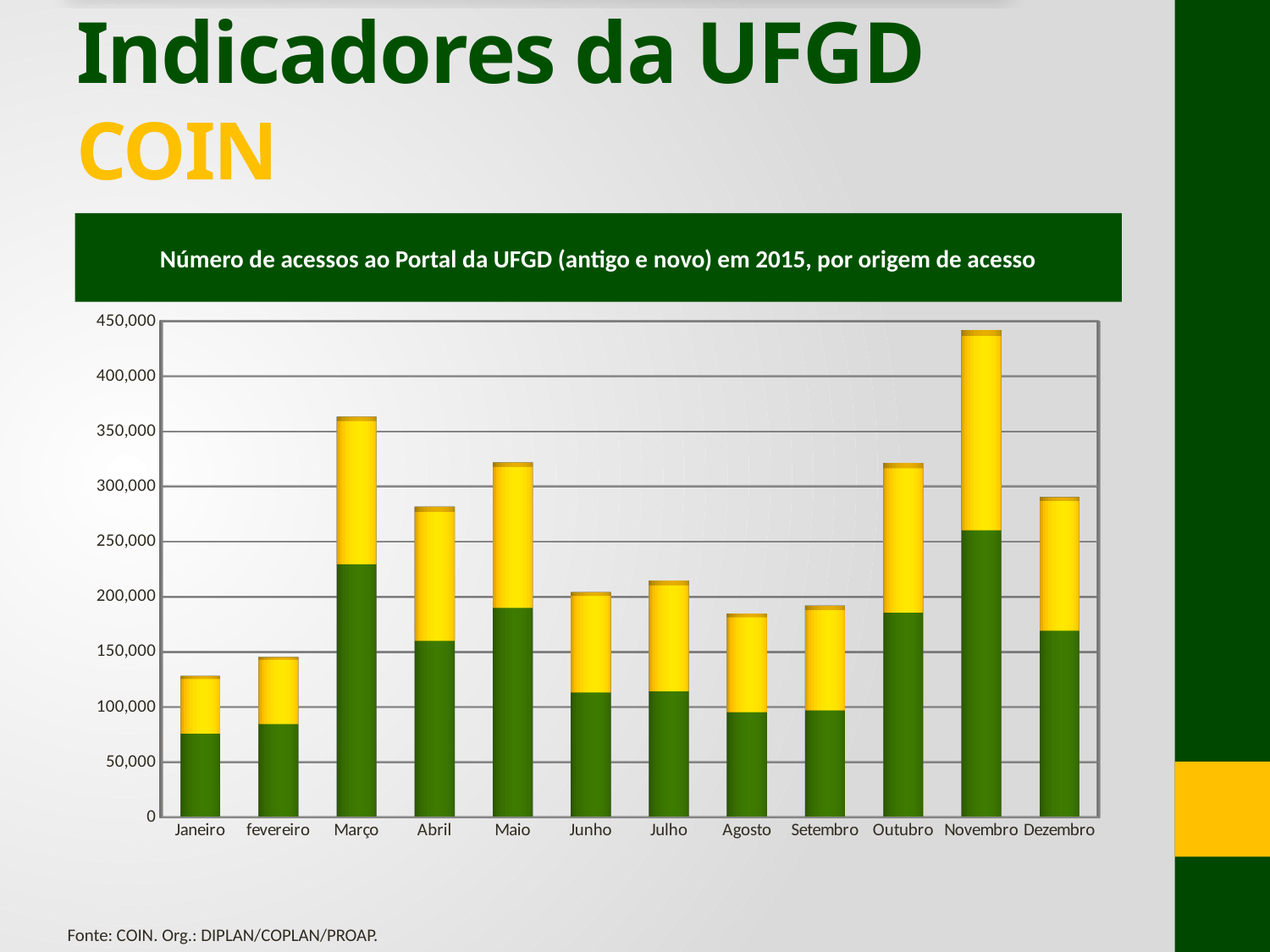
Is the total value for Novembro greater or less than 400,000? greater Is the total value for Janeiro greater or less than 150,000? less What kind of chart is shown on the slide? Stacked bar chart Which month has the highest total number of accesses? Novembro Is the total value for Março greater or less than 350,000? greater How many months are shown along the x axis of the chart? 12 Which month has a larger total, Outubro or Dezembro? Outubro Do the total values rise or fall from Maio to Agosto? fall Which month has a larger total, Março or Abril? Março Which month has the lowest total number of accesses? Janeiro What is the title of the chart? Número de acessos ao Portal da UFGD (antigo e novo) em 2015, por origem de acesso